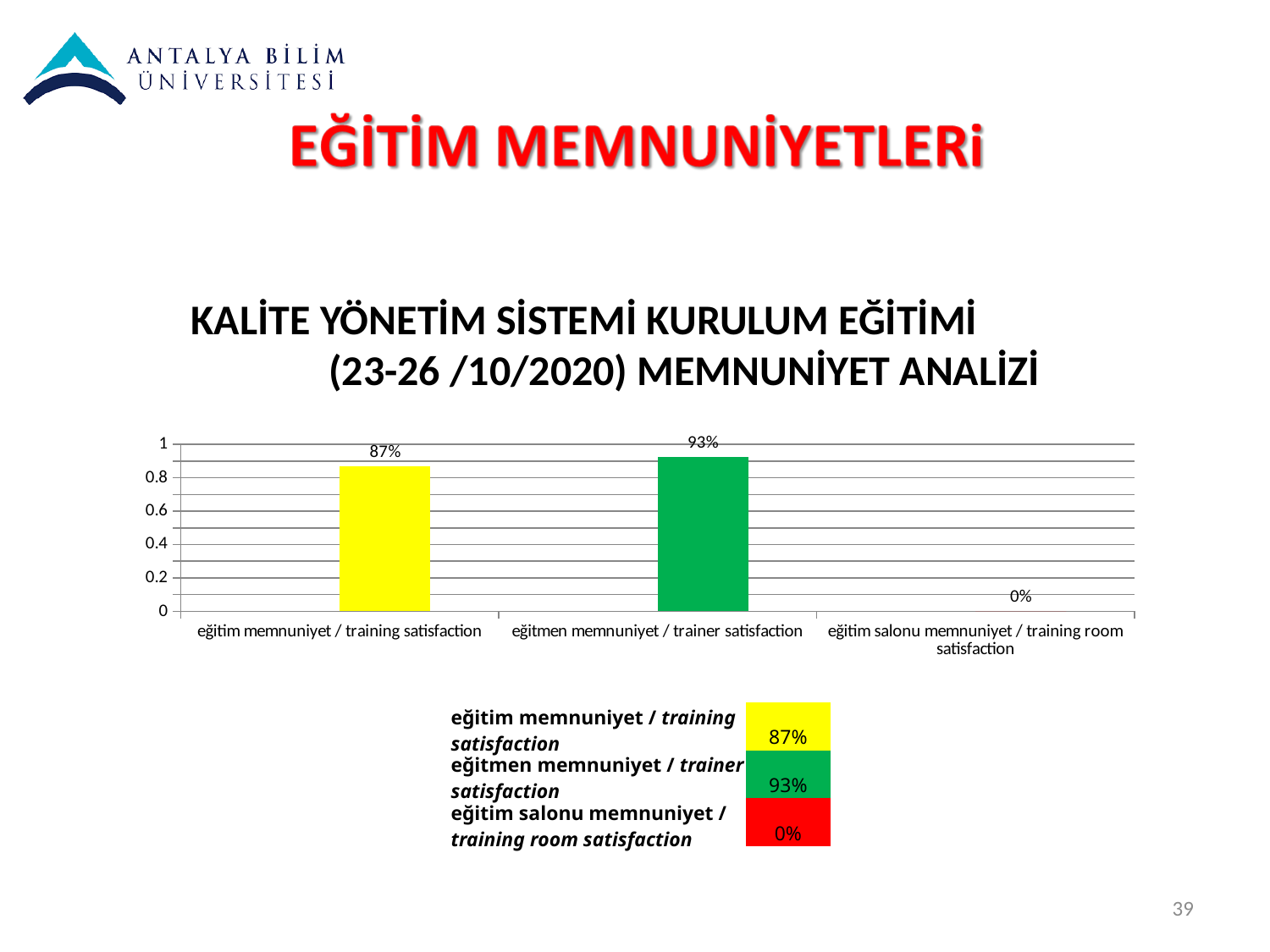
What is the highest tick value shown on the y axis of the chart? 1 How many categories are shown on the x axis of the chart? 3 Is the value for eğitim memnuniyet / training satisfaction greater or less than 0.8? greater Which is larger, the value for training satisfaction or the value for trainer satisfaction? trainer satisfaction What is the value for eğitmen memnuniyet / trainer satisfaction? 93% What is the difference between the values for trainer satisfaction and training satisfaction? 6% Which category has the lowest value? eğitim salonu memnuniyet / training room satisfaction What is the value for eğitim salonu memnuniyet / training room satisfaction? 0% What kind of chart is shown on the slide? bar chart Which category has the highest value? eğitmen memnuniyet / trainer satisfaction What colour is the bar for eğitmen memnuniyet / trainer satisfaction? green What is the value for eğitim memnuniyet / training satisfaction? 87%